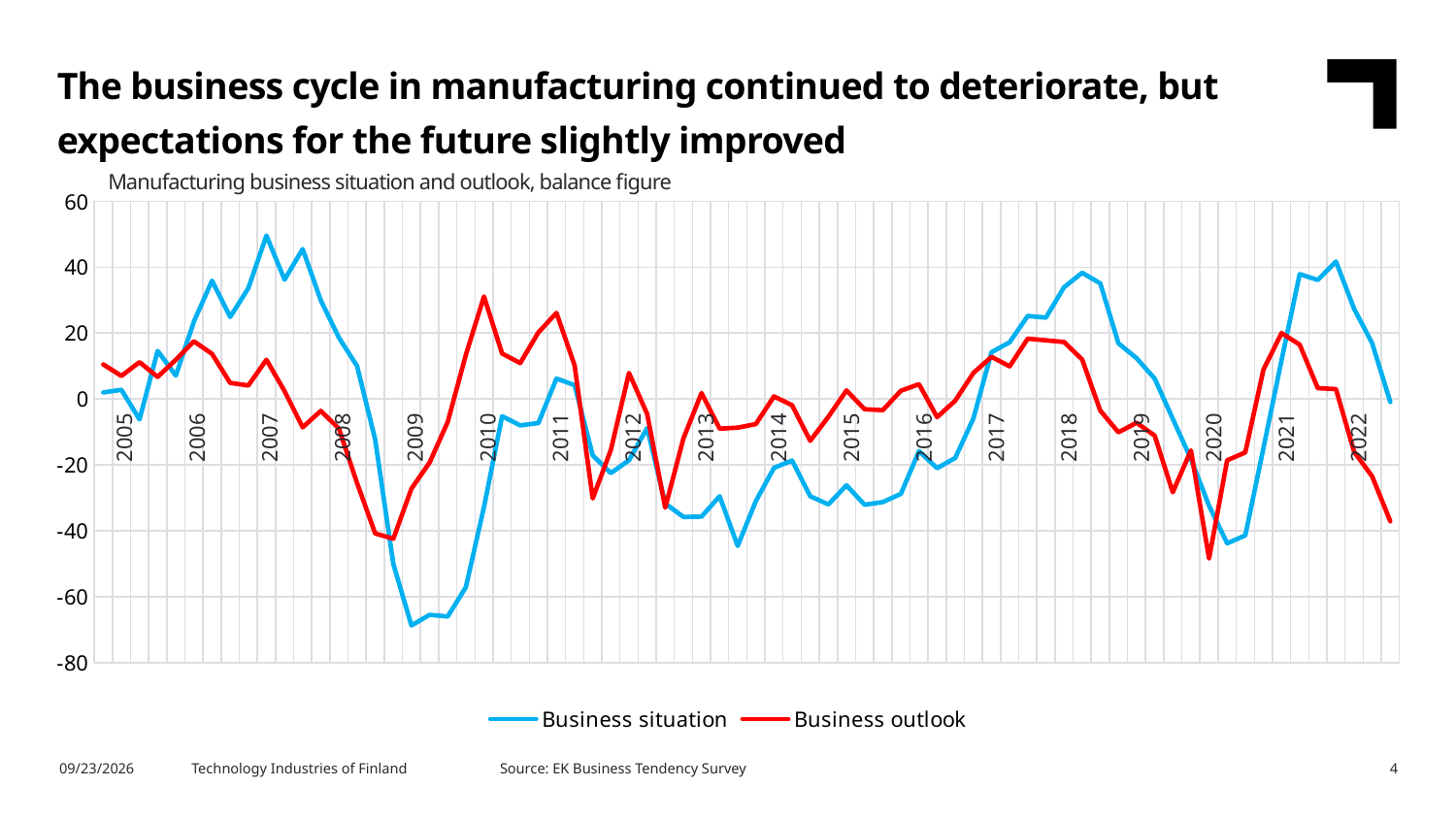
In 2009, which line reaches the lower value, Business situation or Business outlook? Business situation Is the peak of the Business outlook line in 2010 greater or less than 20? greater Does the Business outlook line rise or fall over the course of 2022? Fall What is the title of the chart? Manufacturing business situation and outlook, balance figure Is the lowest value of the Business situation line, reached in 2009, greater or less than -60? less What are the two series named in the legend? Business situation and Business outlook Is the peak of the Business situation line in 2007 greater or less than 40? greater At the end of 2022, which line is higher, Business situation or Business outlook? Business situation How many series does the legend list? 2 How many years are labelled on the x axis? 18 What kind of chart is shown on the slide? Line chart